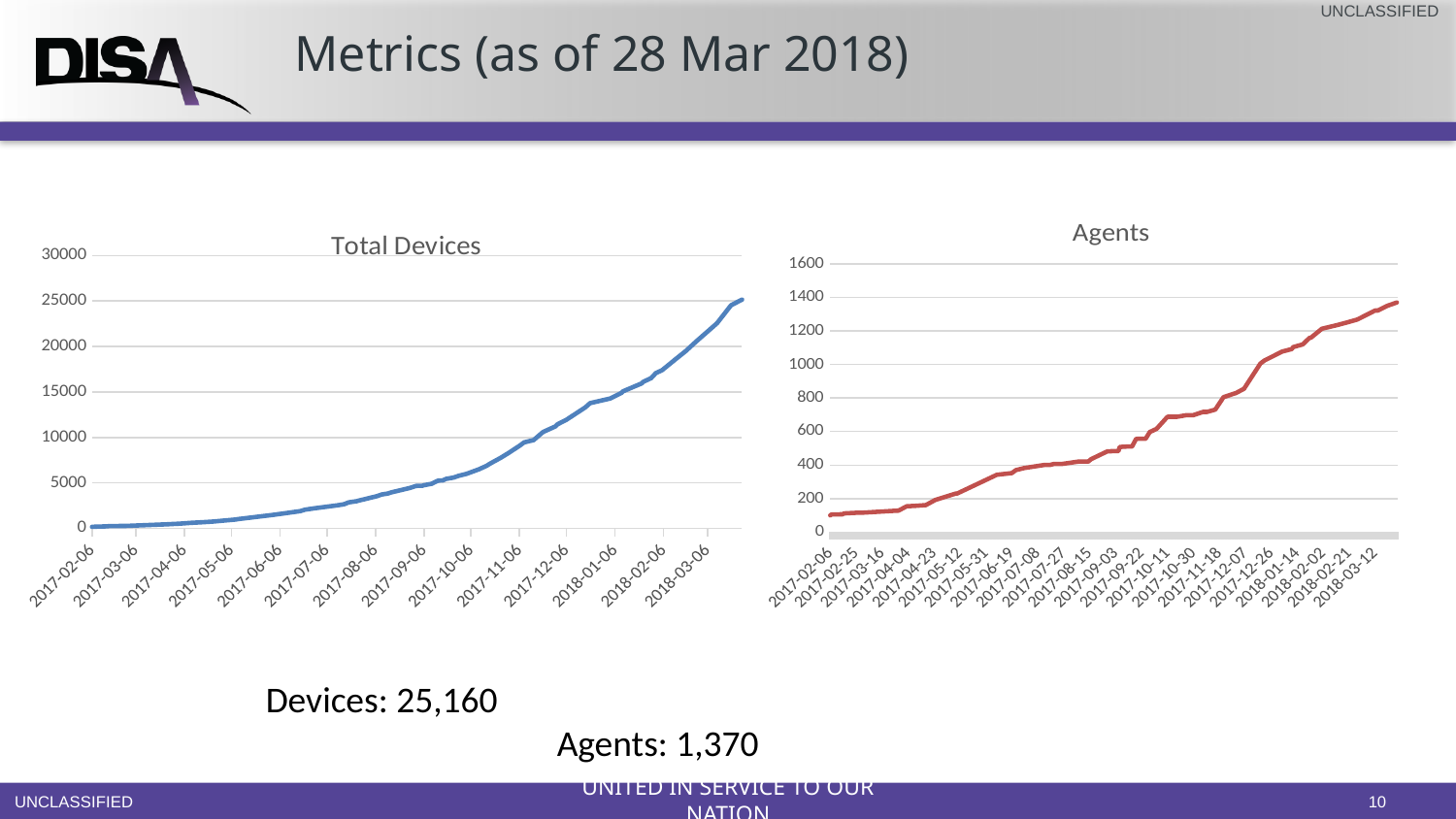
In the Total Devices chart, is the value at 2017-07-06 greater or less than 5000? less In the Agents chart, is the value at 2018-03-12 greater or less than 1200? greater In the Total Devices chart, do the values rise or fall over time along the x axis? rise In the Agents chart, do the values rise or fall over time along the x axis? rise In the Total Devices chart, is the value at 2017-10-06 greater or less than 5000? greater What colour is the line in the Agents chart? red According to the slide, what is the latest total number of devices shown for the Total Devices chart? 25,160 What kind of chart is the Total Devices chart? line chart According to the slide, what is the latest number of agents shown for the Agents chart? 1,370